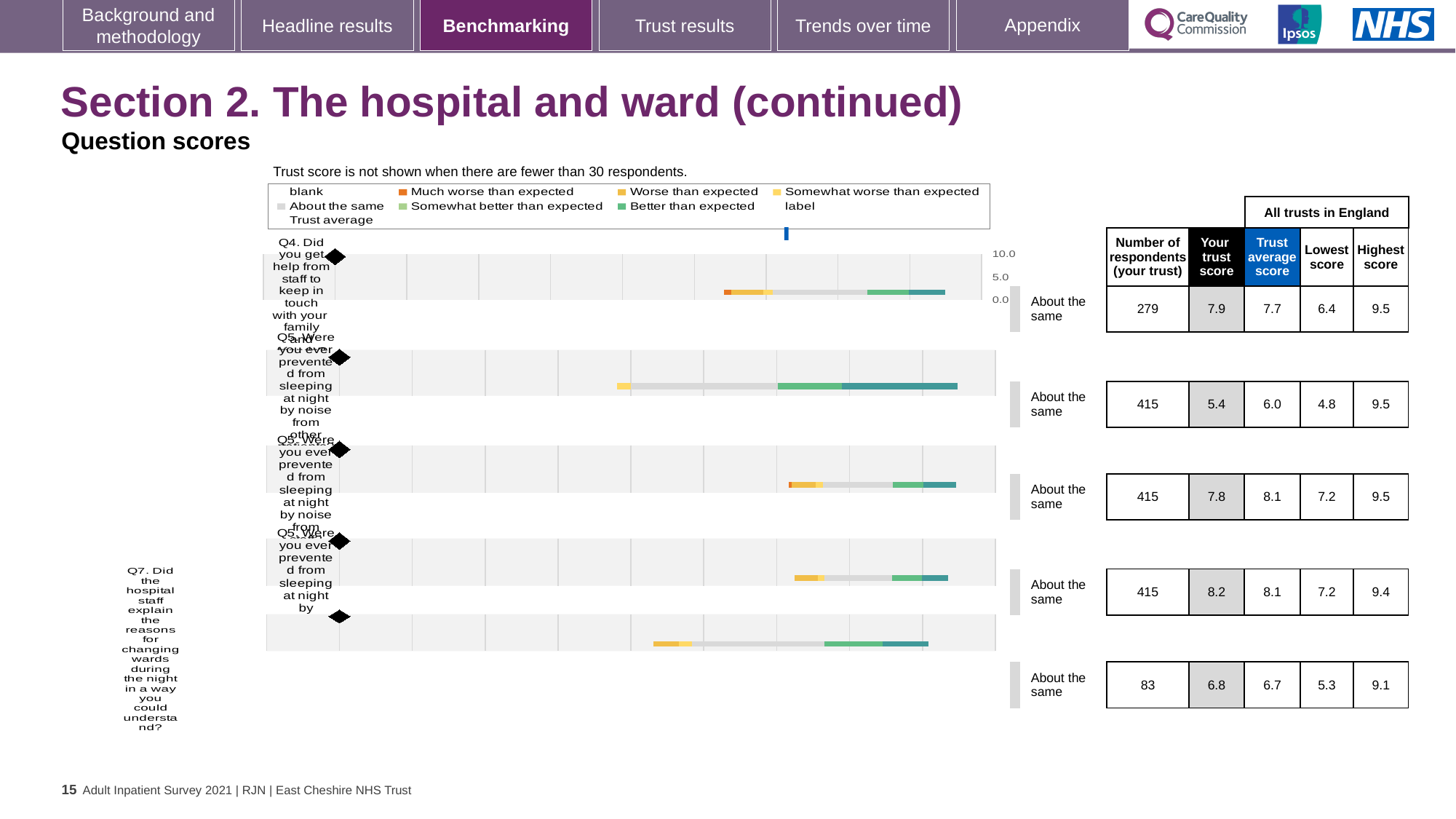
How many respondents from your trust answered Q4? 279 What kind of chart is used to show the question scores on this slide? bar chart What is the highest score across all trusts in England for Q7? 9.1 How many question rows (bars) are shown in the chart? 5 What is the trust average score for the last row, Q7 (explaining reasons for changing wards during the night)? 6.7 What is the highest 'Your trust score' shown in the table? 8.2 What benchmark category is shown next to the Q4 bar? About the same For Q4, what is the difference between your trust score (7.9) and the trust average score (7.7)? 0.2 What is the lowest 'Your trust score' shown in the table? 5.4 For Q7, which is larger: your trust score or the trust average score? Your trust score What is the 'Your trust score' for Q4 (help from staff to keep in touch with family and friends)? 7.9 For the second row (your trust score 5.4, trust average 6.0), what is the difference between the trust average score and your trust score? 0.6